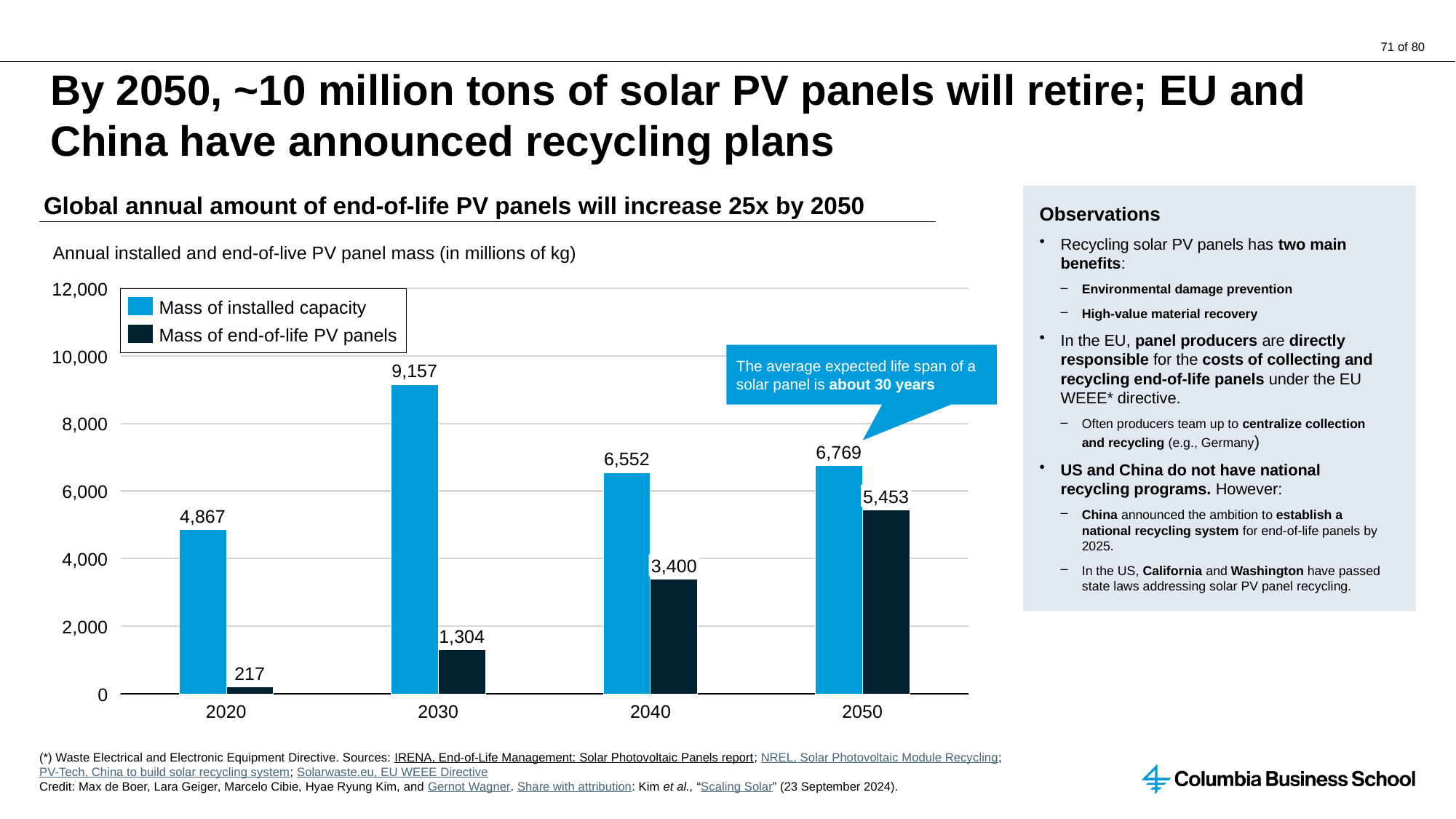
Which is larger in 2050: the mass of installed capacity or the mass of end-of-life PV panels? Mass of installed capacity How many years are shown on the x axis? 4 Does the mass of end-of-life PV panels rise or fall from 2020 to 2050? Rise What is the mass of end-of-life PV panels in 2050? 5,453 What is the mass of end-of-life PV panels in 2020? 217 What kind of chart is shown? Bar chart How many series does the legend list? 2 Which year has the highest mass of installed capacity? 2030 What is the difference between the mass of installed capacity and the mass of end-of-life PV panels in 2040? 3,152 Which year has the lowest mass of end-of-life PV panels? 2020 Is the mass of end-of-life PV panels in 2030 greater or less than 2,000? less What is the mass of installed capacity in 2030? 9,157